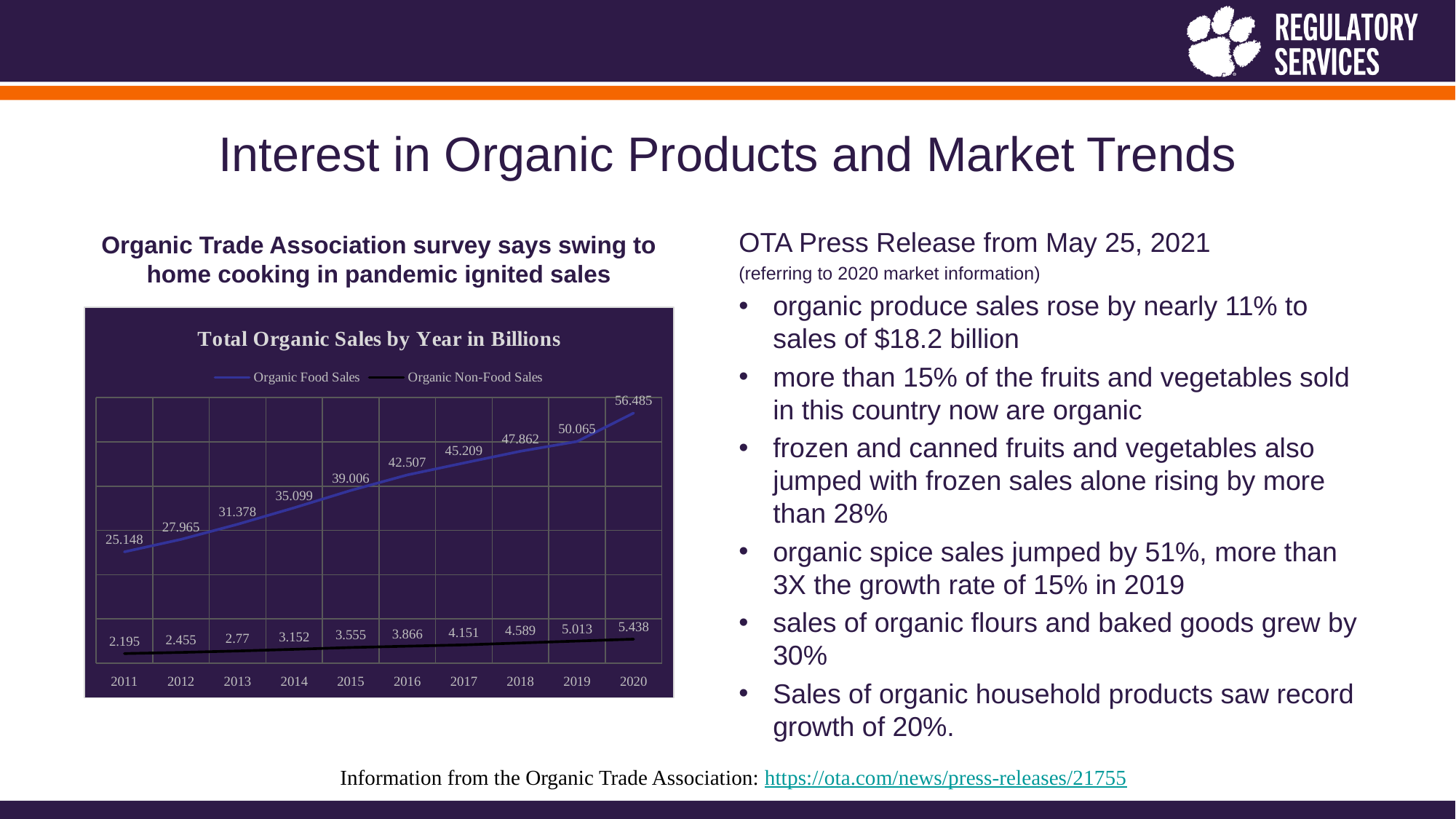
What is the difference between Organic Food Sales in 2020 and 2019? 6.42 How many series does the chart legend list? 2 What is the difference between Organic Non-Food Sales in 2020 and 2011? 3.243 How many years are shown on the x axis of the chart? 10 Which is larger in 2016: Organic Food Sales or Organic Non-Food Sales? Organic Food Sales What is the value of Organic Non-Food Sales in 2011? 2.195 What kind of chart is shown on the slide? Line chart In which year is Organic Food Sales highest? 2020 What is the value of Organic Food Sales in 2015? 39.006 What is the value of Organic Food Sales in 2020? 56.485 In which year is Organic Non-Food Sales lowest? 2011 What is the value of Organic Non-Food Sales in 2018? 4.589